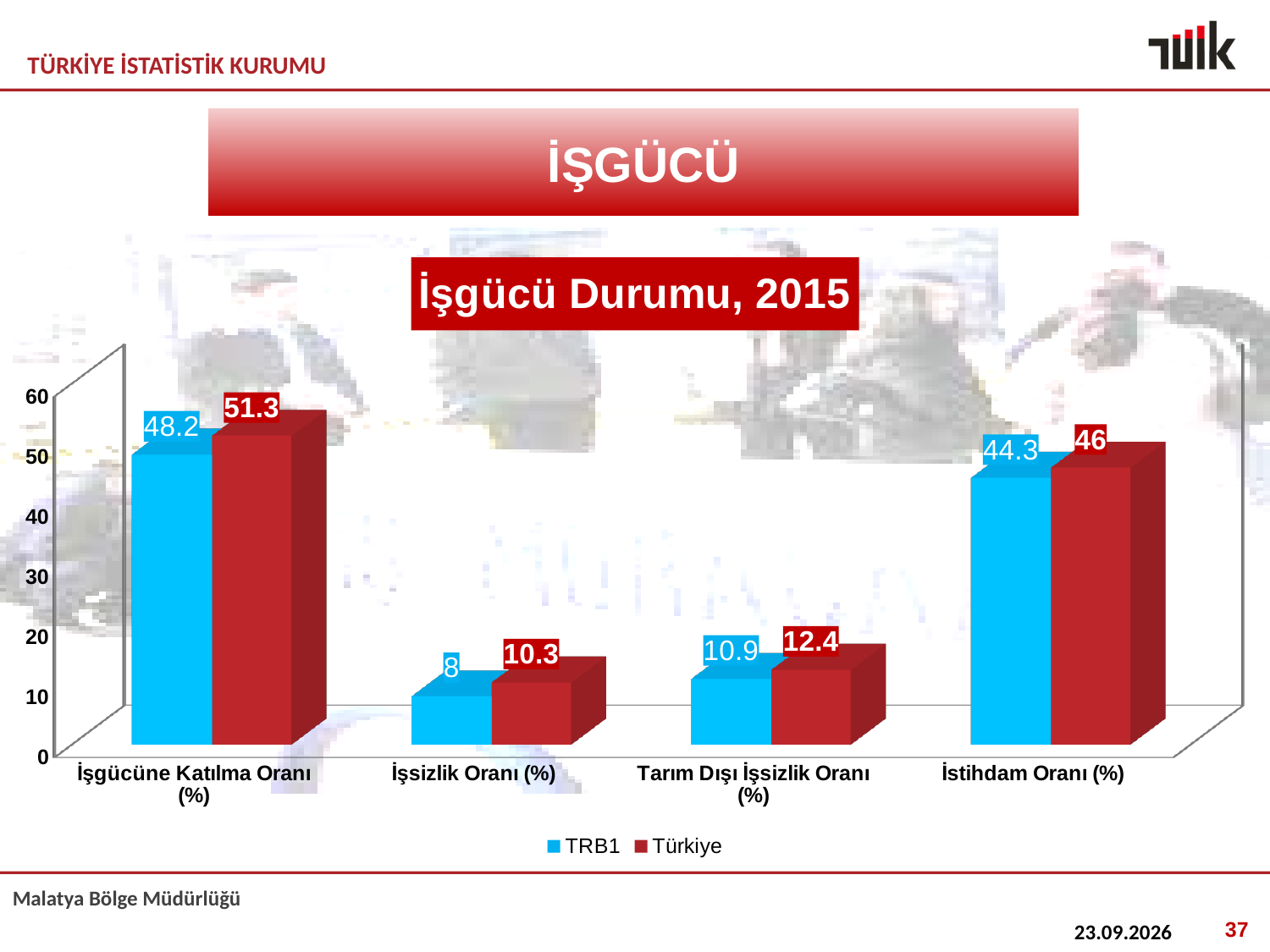
What is the difference between the Türkiye and TRB1 values for İşgücüne Katılma Oranı (%)? 3.1 What is the Türkiye value for İstihdam Oranı (%)? 46 What type of chart is shown on the slide? Bar chart What is the TRB1 value for Tarım Dışı İşsizlik Oranı (%)? 10.9 How many categories are shown on the x axis? 4 Which category has the highest Türkiye value? İşgücüne Katılma Oranı (%) What is the Türkiye value for İşsizlik Oranı (%)? 10.3 Which is larger for İstihdam Oranı (%): the TRB1 value or the Türkiye value? Türkiye Which category has the lowest TRB1 value? İşsizlik Oranı (%) What is the difference between the Türkiye and TRB1 values for İşsizlik Oranı (%)? 2.3 How many series does the legend list? 2 What is the TRB1 value for İşgücüne Katılma Oranı (%)? 48.2